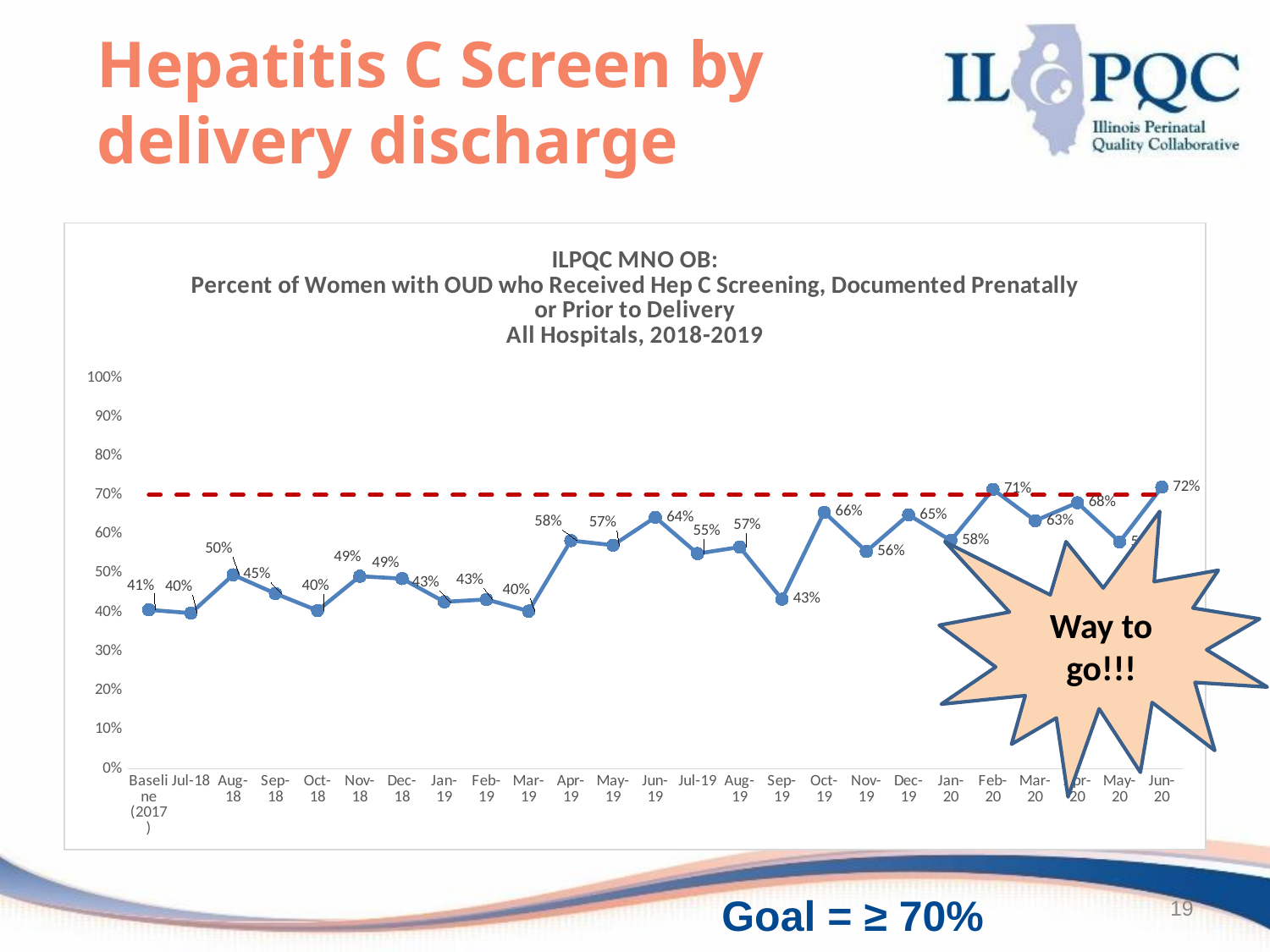
Overall, do the values rise or fall from the Baseline to Jun-20? rise Which month has the highest value on the chart? Jun-20 What is the value for the Baseline (2017) point? 41% What is the value for Sep-19? 43% What is the value for Jun-20? 72% At what percentage is the red dashed goal line drawn? 70% What is the value for Feb-20? 71% What kind of chart is shown on the slide? line chart Which is larger, the value for Oct-19 or the value for Nov-19? Oct-19 Is the value for May-20 greater or less than 70%? less What is the difference between the Jun-20 value and the Baseline (2017) value? 31 percentage points How many data points are plotted on the line? 25